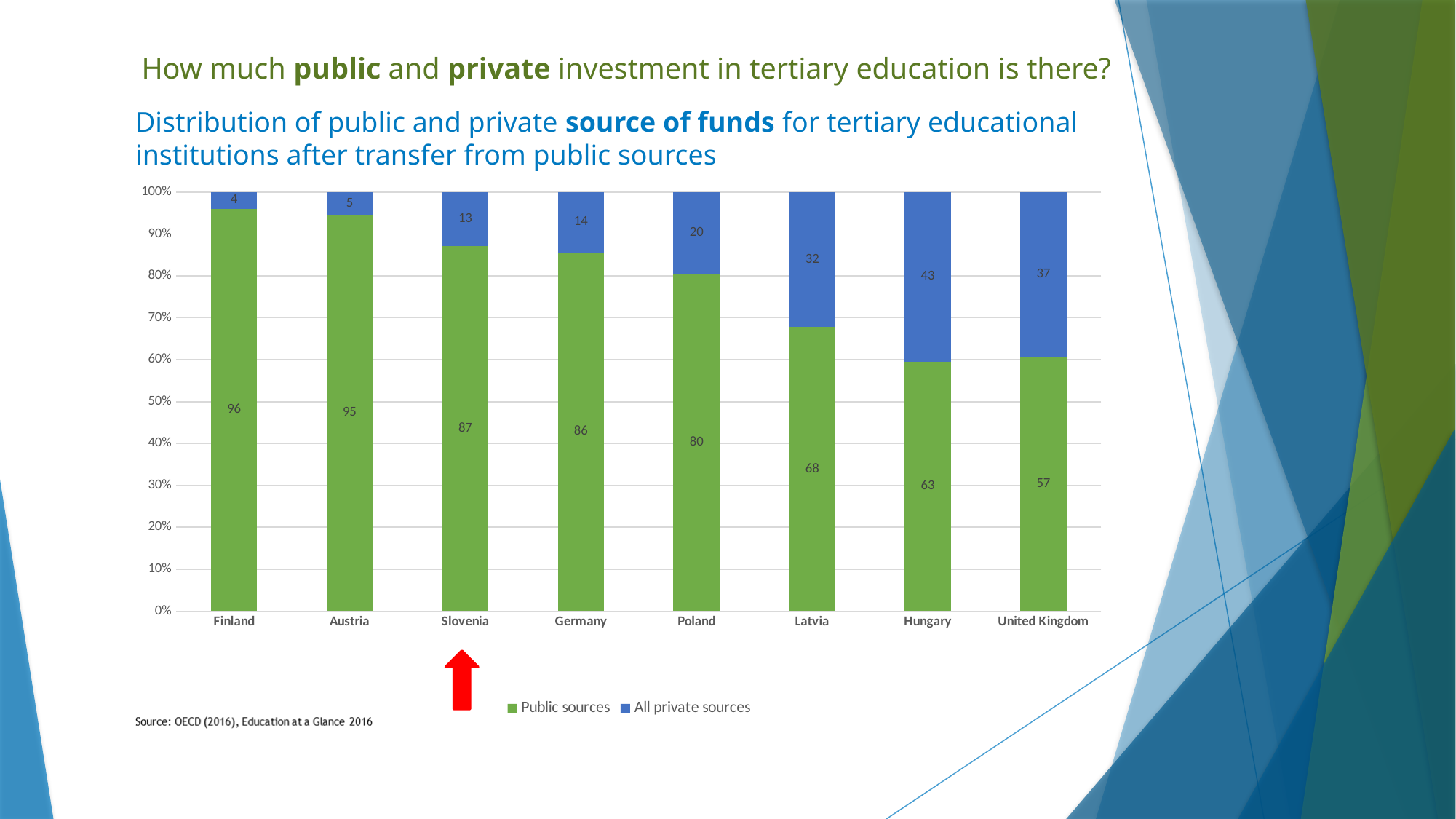
Which country has the lowest value for All private sources? Finland What kind of chart is shown on the slide? Stacked bar chart What is the value for Public sources in Slovenia? 87 How many series does the legend list? 2 Which country has the highest value for All private sources? Hungary How many countries are shown on the x axis? 8 Which is larger, the All private sources value for Poland or for Germany? Poland What is the value for Public sources in the United Kingdom? 57 Which colour represents Public sources in the chart? Green What is the difference between the Public sources values for Finland and Latvia? 28 What is the value for All private sources in Hungary? 43 Which country has the highest value for Public sources? Finland